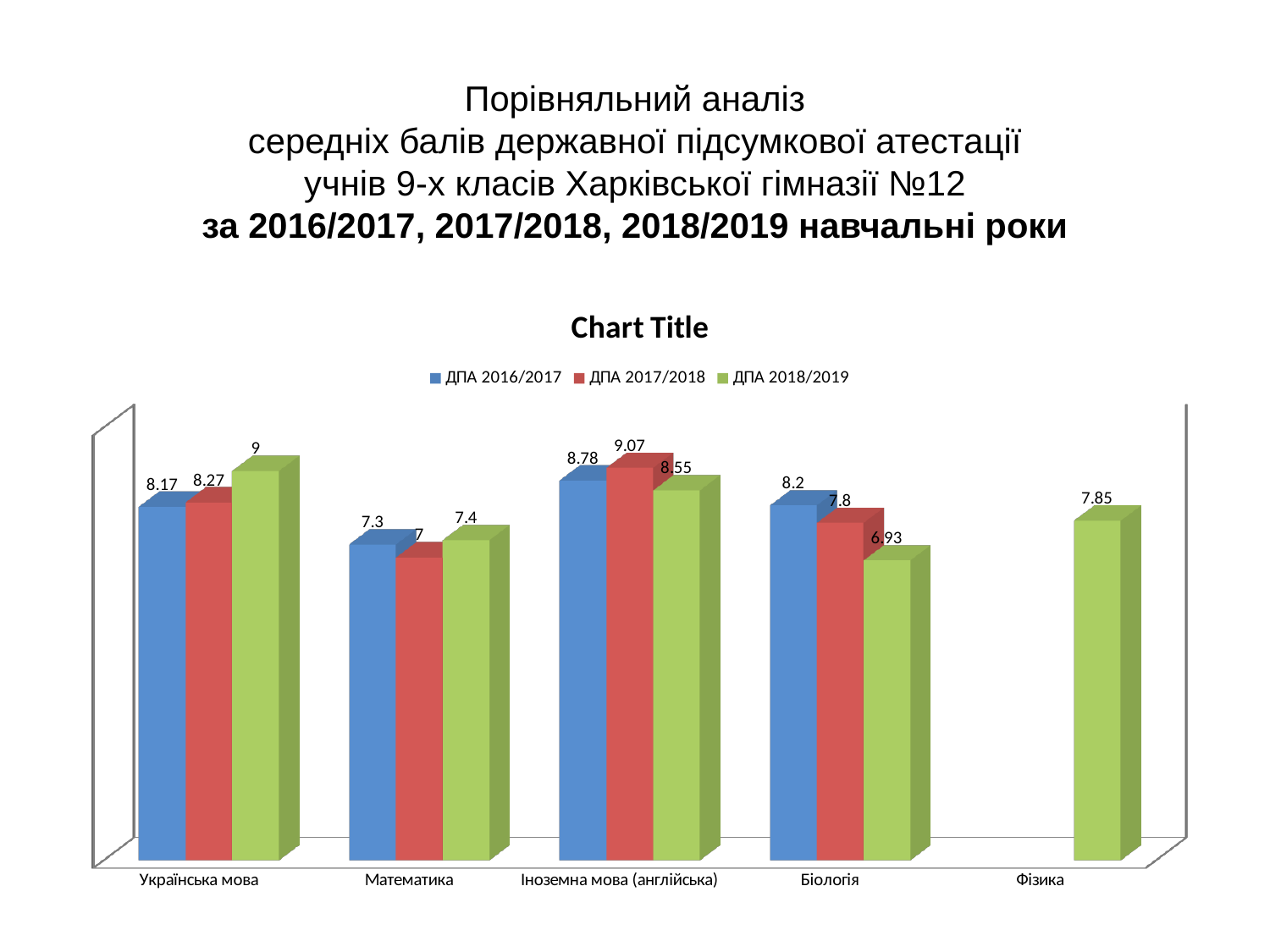
What is the value for Українська мова in the ДПА 2018/2019 series? 9 What is the value for Фізика in the ДПА 2018/2019 series? 7.85 Which category has the lowest value in the ДПА 2018/2019 series? Біологія What kind of chart is shown on the slide? Bar chart What is the title shown above the chart? Chart Title What is the value for Математика in the ДПА 2017/2018 series? 7 Which is larger for Математика: the ДПА 2016/2017 value or the ДПА 2018/2019 value? ДПА 2018/2019 What is the difference between the ДПА 2017/2018 and ДПА 2016/2017 values for Біологія? 0.4 What is the value for Іноземна мова (англійська) in the ДПА 2017/2018 series? 9.07 How many series does the legend list? 3 How many categories are shown on the x axis? 5 Which category has the highest value in the ДПА 2016/2017 series? Іноземна мова (англійська)